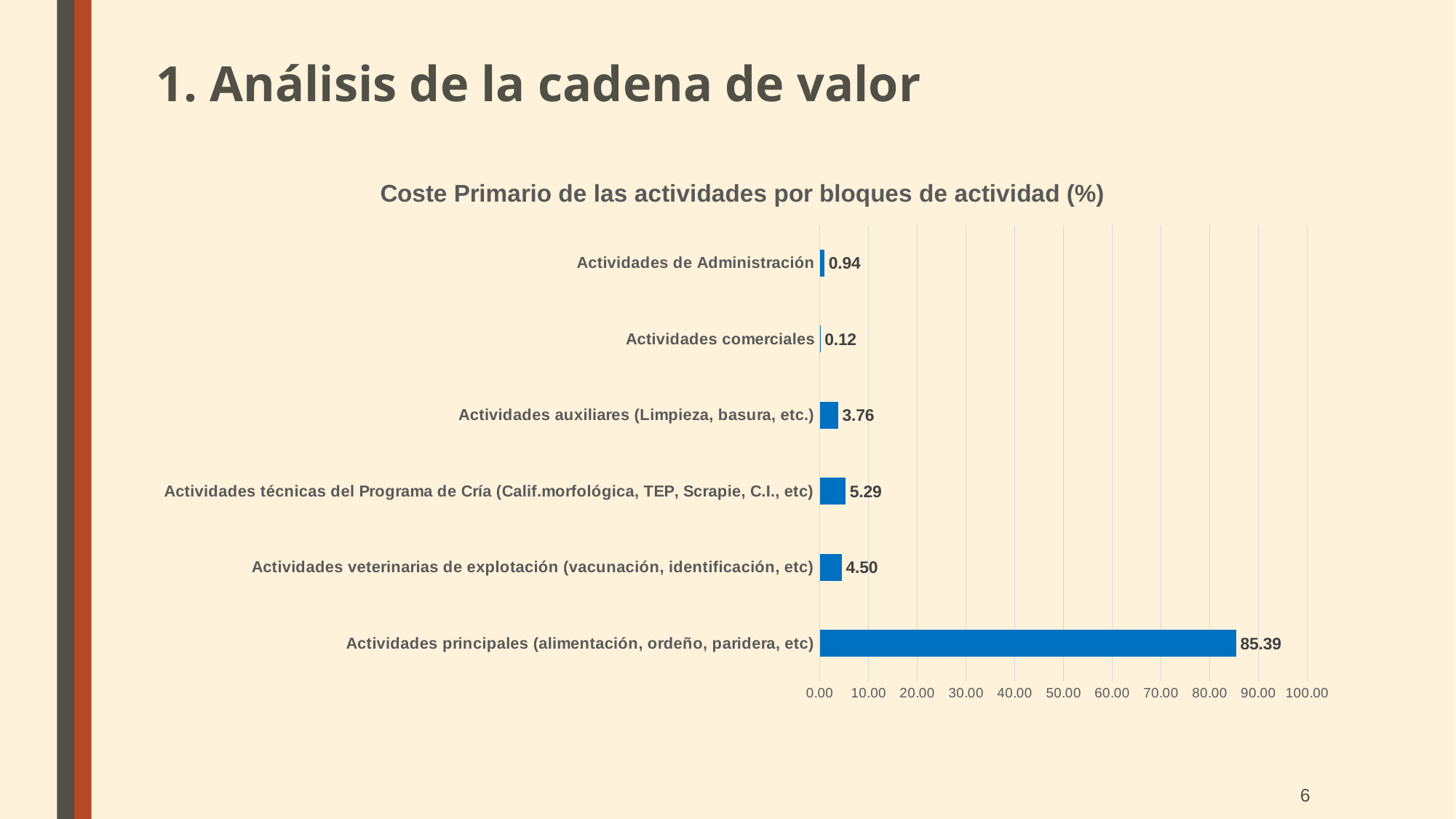
What is the value for Actividades de Administración? 0.94 What is the value for Actividades auxiliares (Limpieza, basura, etc.)? 3.76 What is the difference between the values for Actividades técnicas del Programa de Cría and Actividades veterinarias de explotación? 0.79 What is the value for Actividades principales (alimentación, ordeño, paridera, etc)? 85.39 What kind of chart is shown on the slide? bar chart Which category has the lowest value? Actividades comerciales What is the title of the chart? Coste Primario de las actividades por bloques de actividad (%) Is the value for Actividades principales (alimentación, ordeño, paridera, etc) greater or less than 80.00? greater How many categories are shown in the chart? 6 What is the value for Actividades comerciales? 0.12 Which is larger: the value for Actividades auxiliares (Limpieza, basura, etc.) or the value for Actividades veterinarias de explotación (vacunación, identificación, etc)? Actividades veterinarias de explotación (vacunación, identificación, etc) Which category has the highest value? Actividades principales (alimentación, ordeño, paridera, etc)